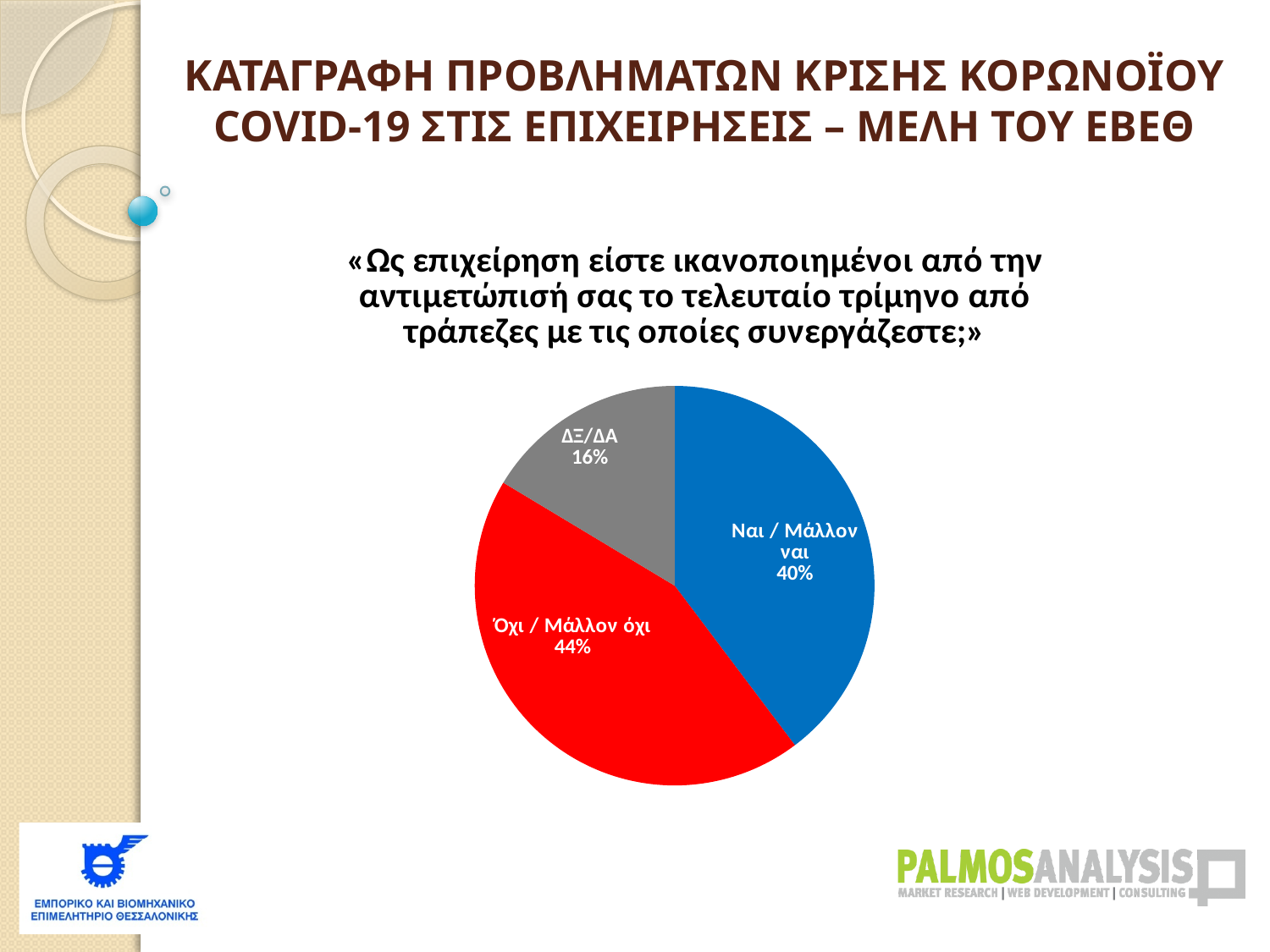
What kind of chart is shown on the slide? pie chart What percentage of respondents answered "ΔΞ/ΔΑ"? 16% What colour is the slice for "Όχι / Μάλλον όχι"? red What colour is the slice for "ΔΞ/ΔΑ"? grey What percentage of respondents answered "Ναι / Μάλλον ναι"? 40% Which response has the smallest share of the pie? ΔΞ/ΔΑ How many slices does the pie chart have? 3 Which response has the largest share of the pie? Όχι / Μάλλον όχι Which is larger, the share for "Ναι / Μάλλον ναι" or the share for "ΔΞ/ΔΑ"? Ναι / Μάλλον ναι What percentage of respondents answered "Όχι / Μάλλον όχι"? 44% What is the difference in percentage points between "Όχι / Μάλλον όχι" and "Ναι / Μάλλον ναι"? 4 percentage points What is the combined share of "Ναι / Μάλλον ναι" and "Όχι / Μάλλον όχι"? 84%